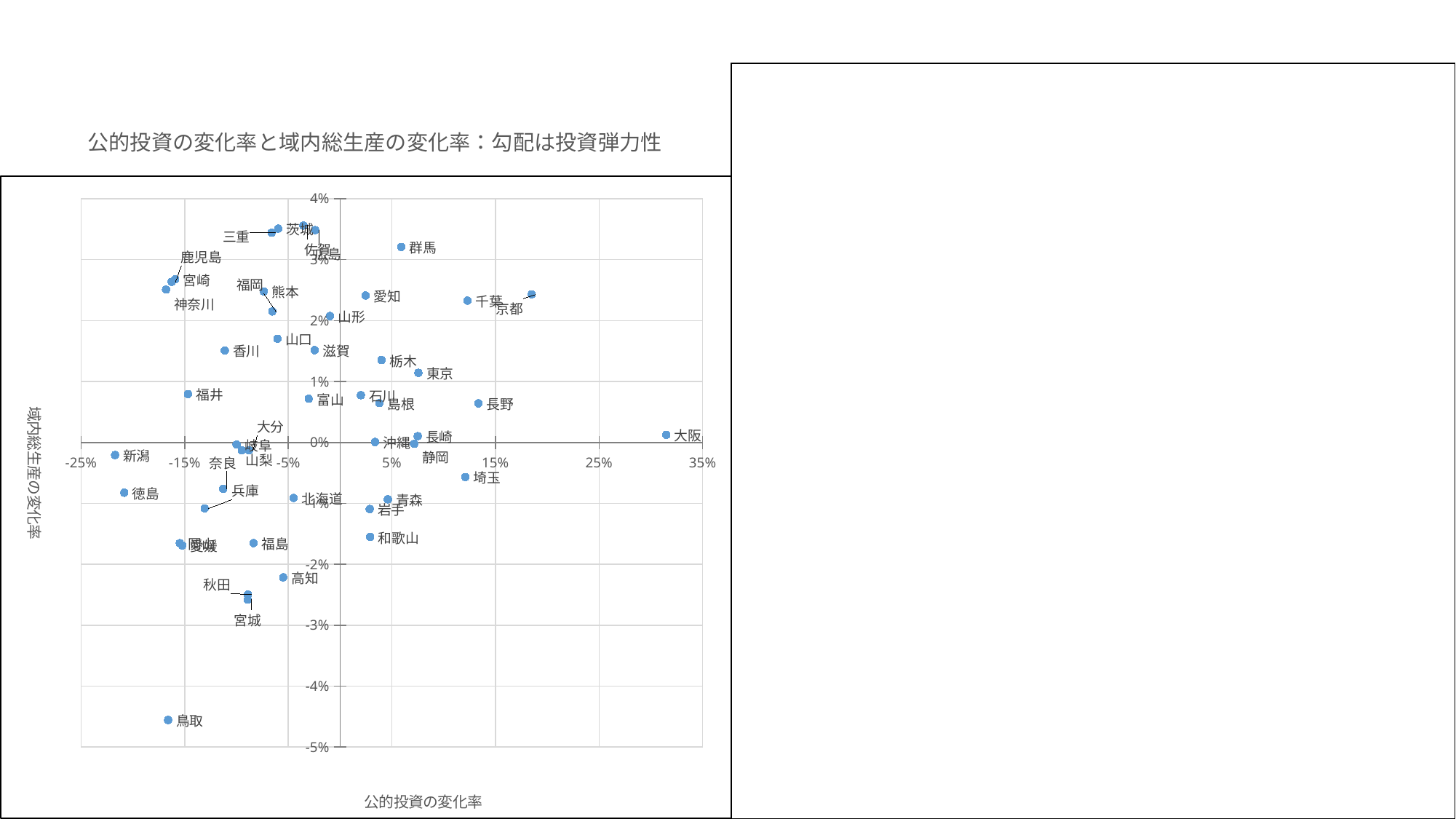
Which prefecture has the highest value on the horizontal axis (公的投資の変化率)? 大阪 Is the vertical-axis value for 高知 greater or less than -2%? less Is the vertical-axis value for 群馬 greater or less than 3%? greater What kind of chart is shown on the slide? Scatter chart Is the vertical-axis value for 鳥取 greater or less than -4%? less Which has the larger horizontal-axis value, 大阪 or 京都? 大阪 Which has the larger vertical-axis value, 群馬 or 東京? 群馬 Which prefecture has the lowest value on the horizontal axis (公的投資の変化率)? 新潟 What is the title of the chart? 公的投資の変化率と域内総生産の変化率：勾配は投資弾力性 What is the label of the horizontal axis? 公的投資の変化率 Which prefecture has the lowest value on the vertical axis (域内総生産の変化率)? 鳥取